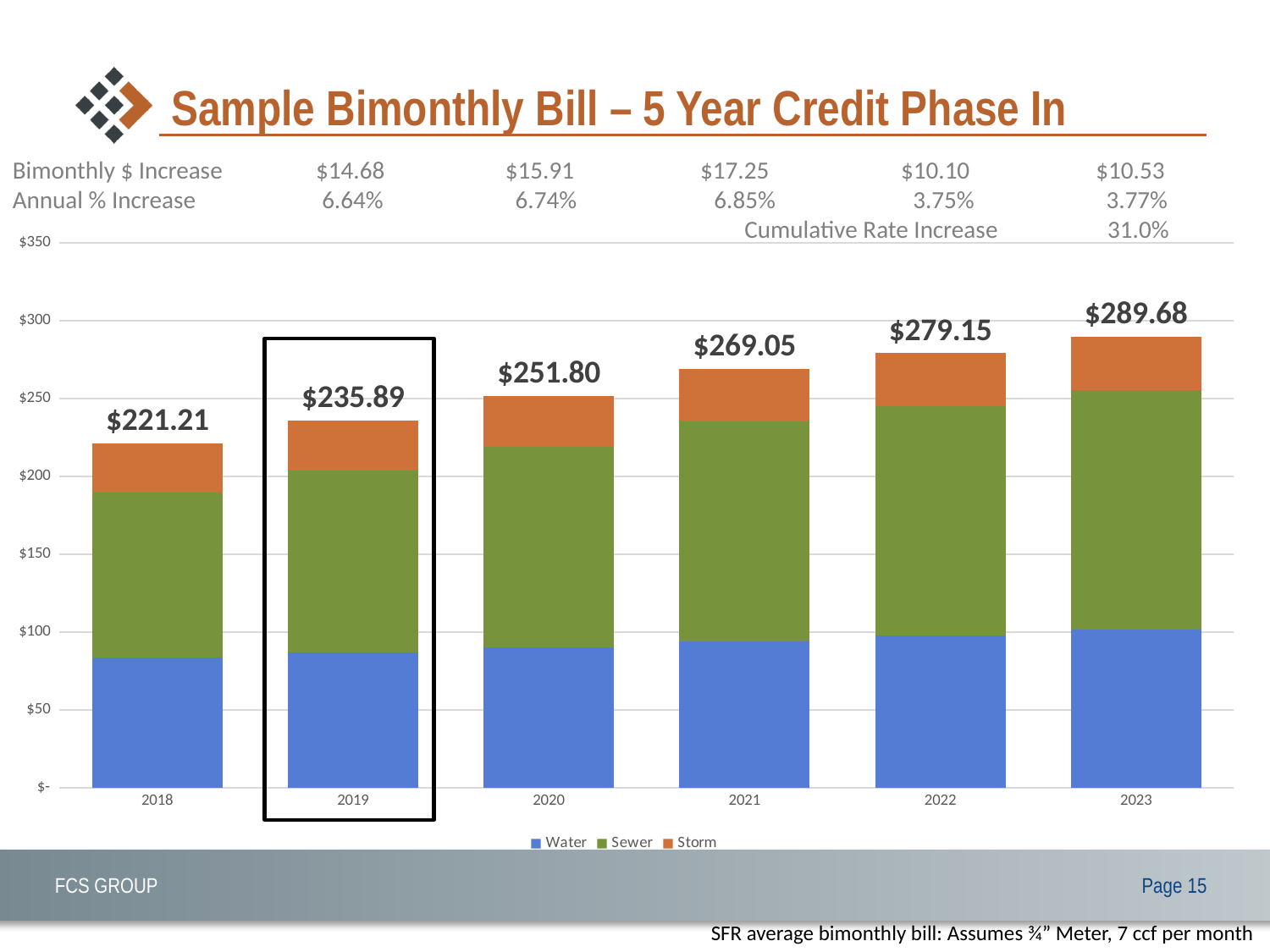
Is the Water portion of the 2018 bar greater or less than $100? less What is the total bimonthly bill shown for 2018? $221.21 Which year has the highest total bimonthly bill? 2023 How many years are shown on the x axis of the chart? 6 What is the total bimonthly bill shown for 2023? $289.68 Which is larger, the total bill for 2022 or the total bill for 2021? 2022 What is the total bimonthly bill shown for 2021? $269.05 Which year has the lowest total bimonthly bill? 2018 What is the difference between the total bill for 2020 and the total bill for 2019? $15.91 How many series does the chart legend list? 3 Do the total bimonthly bills rise or fall from 2018 to 2023? rise What is the difference between the total bill for 2023 and the total bill for 2018? $68.47